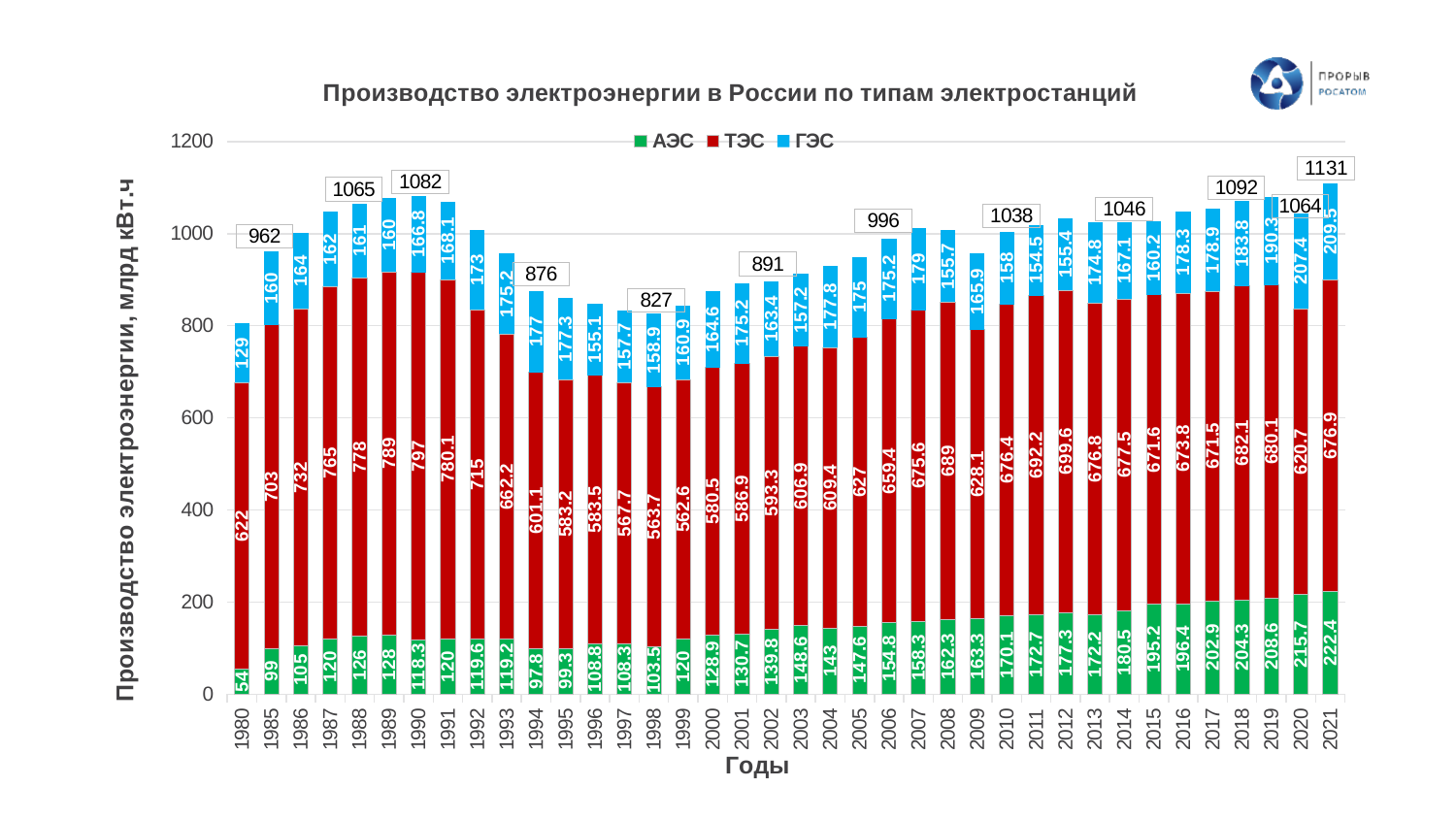
In which year is the АЭС value the lowest? 1980 What type of chart is shown on the slide? Stacked bar chart What is the total of the stacked bar for 1980? 805 What is the value of АЭС for 2015? 195.2 In which year is the АЭС value the highest? 2021 What is the difference between the ТЭС values for 1990 and 1998? 233.3 How many series does the legend list? 3 How many years are shown on the x axis? 38 What is the value of ТЭС for 1990? 797 What is the total labelled above the bar for 2021? 1131 What is the value of ГЭС for 2021? 209.5 Which is larger, the ГЭС value for 2008 or for 2013? 2013